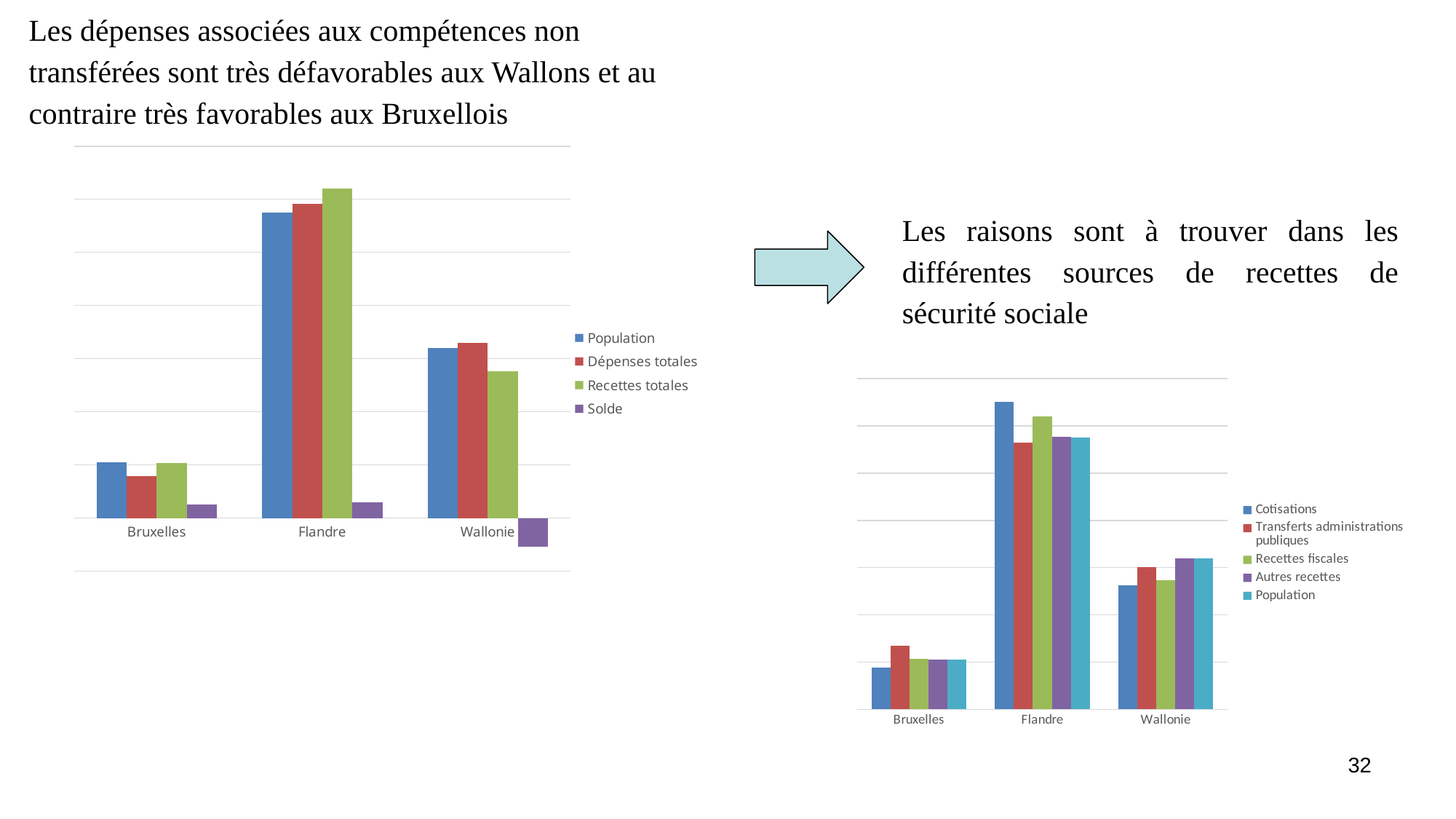
What kind of chart is the chart on the left of the slide? bar chart In the right chart, how many series does the legend list? 5 In the right chart, which category has the highest Cotisations bar? Flandre In the right chart, for Wallonie, which is larger: Cotisations or Autres recettes? Autres recettes In the left chart, which category has the highest Population bar? Flandre In the left chart, for Bruxelles, which is larger: Dépenses totales or Recettes totales? Recettes totales What kind of chart is the chart on the right of the slide? bar chart In the left chart, which category has the lowest Solde value? Wallonie In the left chart, how many categories are shown on the x axis? 3 In the left chart, for Wallonie, which is larger: Dépenses totales or Recettes totales? Dépenses totales In the left chart, how many series does the legend list? 4 In the right chart, which series is listed second in the legend? Transferts administrations publiques